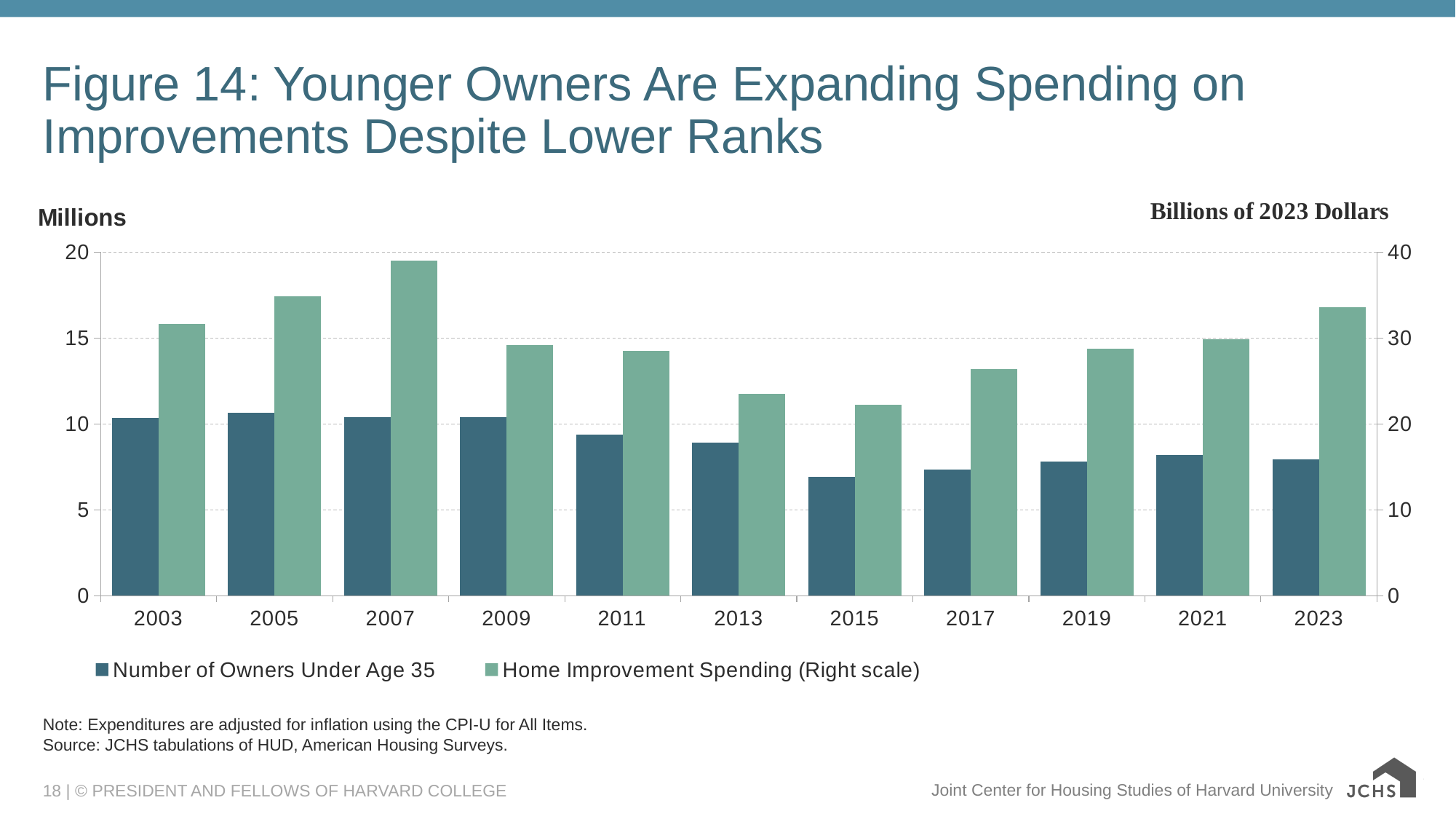
Is Home Improvement Spending in 2023 greater or less than 30 billion? greater Is Home Improvement Spending in 2013 greater or less than 25 billion? less Is the Number of Owners Under Age 35 in 2013 greater or less than 10 million? less In which year is Home Improvement Spending highest? 2007 In which year is the Number of Owners Under Age 35 lowest? 2015 Does Home Improvement Spending rise or fall from 2015 to 2023? rise How many series does the legend list? 2 What kind of chart is shown on the slide? bar chart Which year has higher Home Improvement Spending, 2005 or 2007? 2007 Which year has the larger Number of Owners Under Age 35, 2015 or 2021? 2021 How many years are shown on the x axis? 11